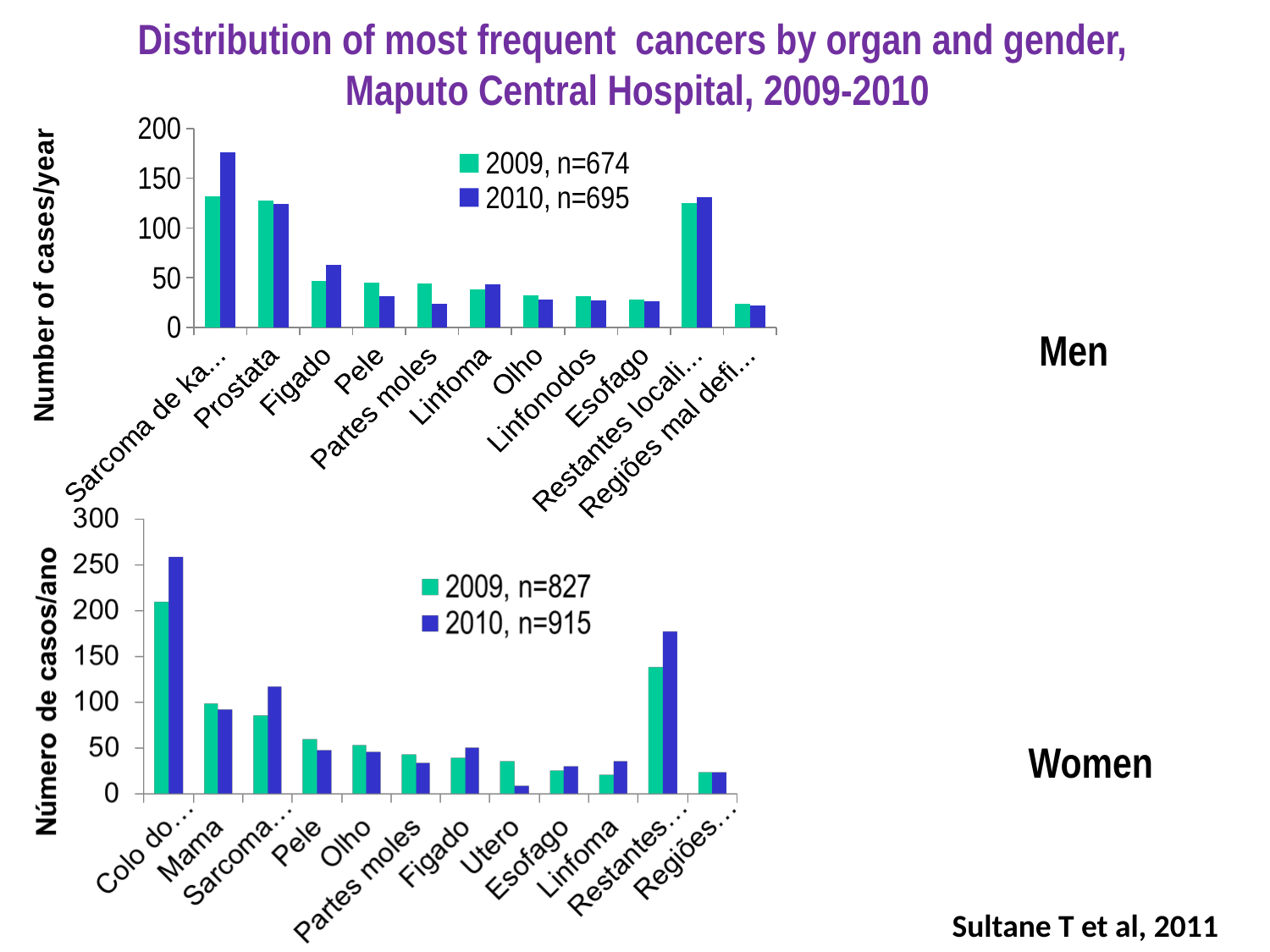
In the Men chart (top), which is larger for Figado: the 2009, n=674 value or the 2010, n=695 value? 2010, n=695 In the Women chart (bottom), which category has the tallest bar for 2010, n=915? Colo do... In the Men chart (top), which category has the tallest bar for 2010, n=695? Sarcoma de ka... In the Women chart (bottom), which category has the shortest bar for 2010, n=915? Utero How many series does the legend of the Men chart (top) list? 2 In the Men chart (top), is the value for Figado in 2010, n=695 greater or less than 50? greater What type of chart is the Men chart (top)? Bar chart How many categories are shown on the x axis of the Women chart (bottom)? 12 In the Men chart (top), is the value for Prostata in 2009, n=674 greater or less than 100? greater In the Women chart (bottom), which is larger for Sarcoma...: the 2009, n=827 value or the 2010, n=915 value? 2010, n=915 In the Women chart (bottom), is the value for Restantes... in 2010, n=915 greater or less than 150? greater